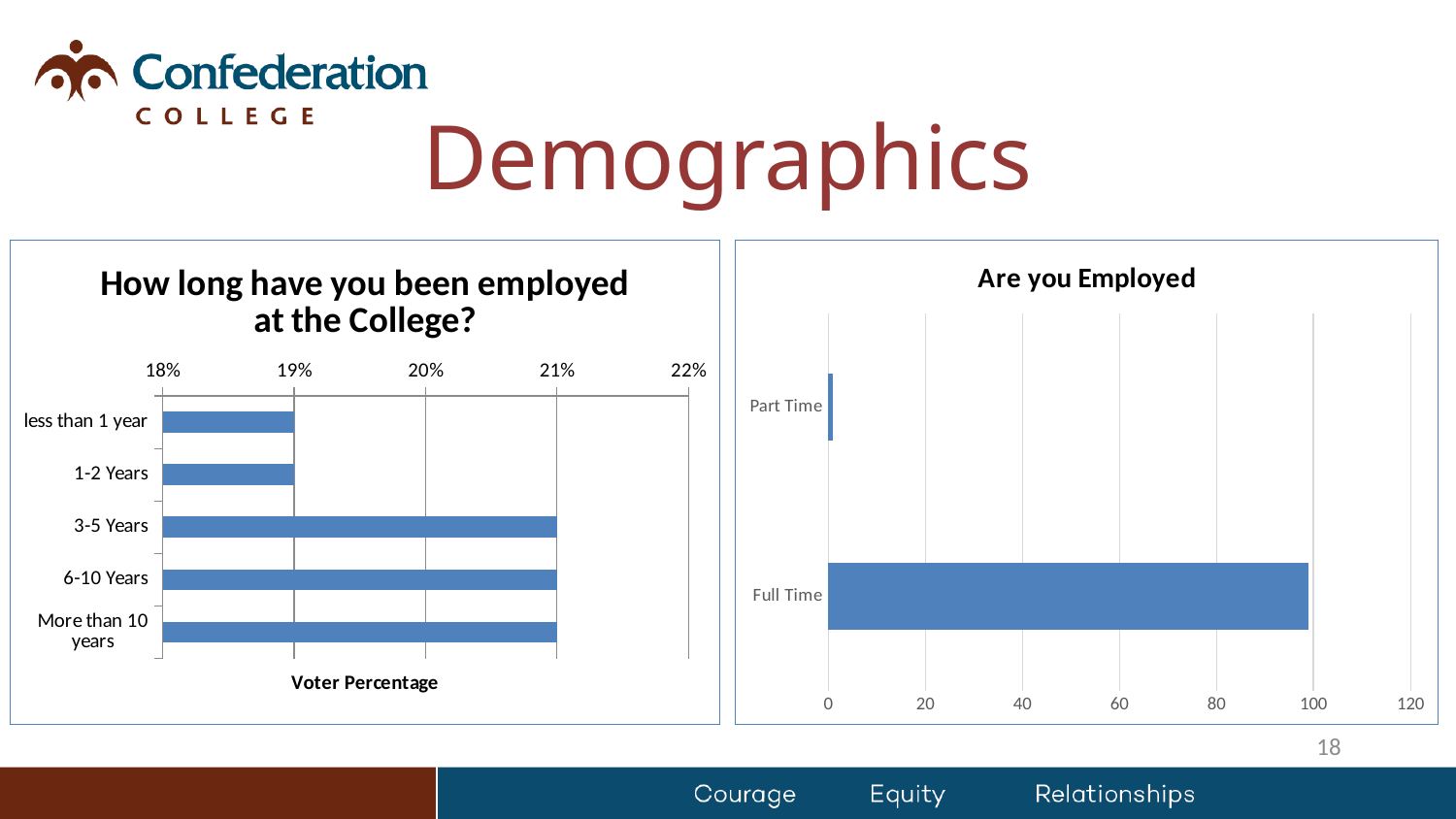
On the chart titled "How long have you been employed at the College?", is the value for less than 1 year greater or less than 20%? less On the chart titled "How long have you been employed at the College?", is the value for 3-5 Years greater or less than 20%? greater On the chart titled "How long have you been employed at the College?", which is larger, the value for 6-10 Years or the value for 1-2 Years? 6-10 Years What kind of chart is the chart titled "Are you Employed"? bar chart On the chart titled "Are you Employed", is the value for Part Time greater or less than 20? less On the chart titled "Are you Employed", which category has the lowest value? Part Time On the chart titled "Are you Employed", how many categories are shown? 2 On the chart titled "How long have you been employed at the College?", what is the label on the horizontal axis? Voter Percentage On the chart titled "Are you Employed", which category has the highest value? Full Time On the chart titled "How long have you been employed at the College?", how many categories are shown? 5